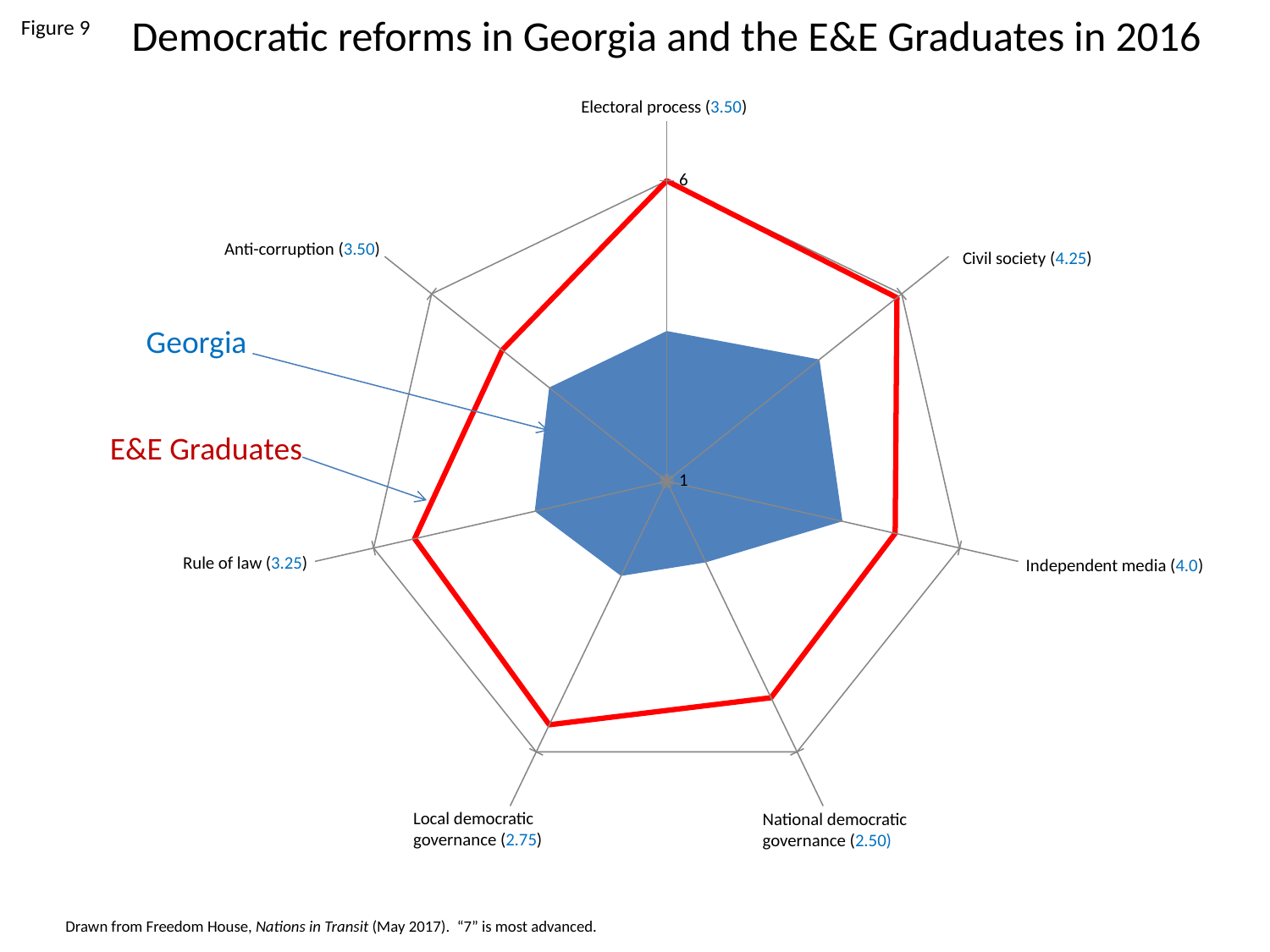
On the Civil society axis, which series has the higher value, Georgia or E&E Graduates? E&E Graduates What is Georgia's score for Independent media? 4.0 What is Georgia's score for National democratic governance? 2.50 What type of chart is shown on the slide? Radar chart Which is larger for Georgia: the Electoral process score or the Rule of law score? Electoral process What is Georgia's score for Civil society? 4.25 On which dimension does Georgia have its lowest score? National democratic governance On which dimension does Georgia have its highest score? Civil society How many series are plotted on the chart? 2 How many dimensions (axes) does the chart show? 7 What is the difference between Georgia's Civil society score and its National democratic governance score? 1.75 What is Georgia's score for Rule of law? 3.25